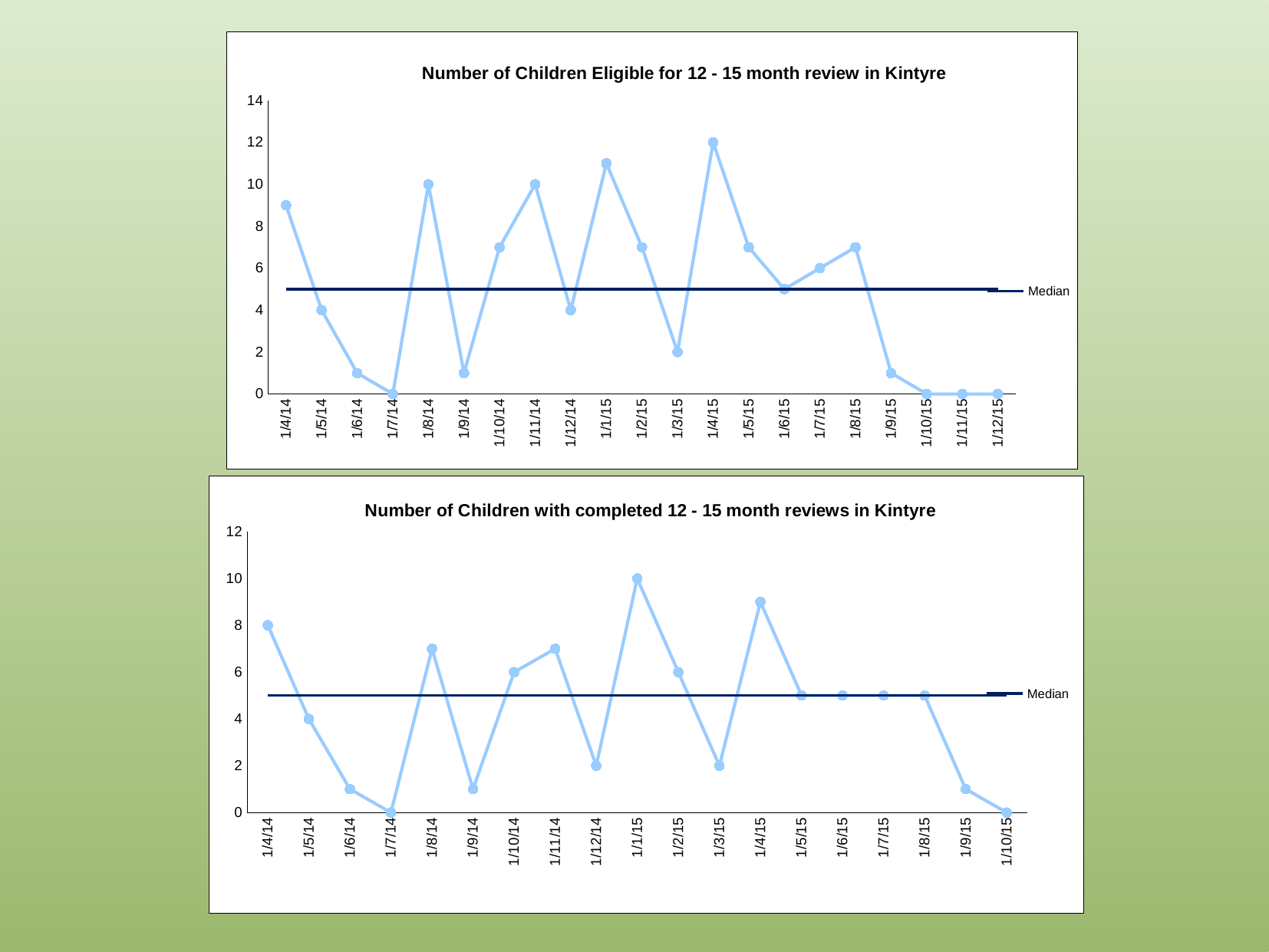
How many data points are plotted on the top chart (Number of Children Eligible for 12 - 15 month review in Kintyre)? 21 In the top chart (Number of Children Eligible for 12 - 15 month review in Kintyre), which date has the highest value? 1/4/15 What kind of chart is the top chart, 'Number of Children Eligible for 12 - 15 month review in Kintyre'? line chart In the top chart (Number of Children Eligible for 12 - 15 month review in Kintyre), what is the difference between the values for 1/4/15 and 1/8/14? 2 What is the label of the horizontal reference line shown in the legend of the bottom chart (Number of Children with completed 12 - 15 month reviews in Kintyre)? Median In the bottom chart (Number of Children with completed 12 - 15 month reviews in Kintyre), which is larger: the value for 1/10/14 or the value for 1/12/14? 1/10/14 In the top chart (Number of Children Eligible for 12 - 15 month review in Kintyre), what is the value for 1/8/14? 10 In the bottom chart (Number of Children with completed 12 - 15 month reviews in Kintyre), what is the value for 1/4/14? 8 In the top chart (Number of Children Eligible for 12 - 15 month review in Kintyre), is the value for 1/1/15 greater or less than 10? greater In the bottom chart (Number of Children with completed 12 - 15 month reviews in Kintyre), which date has the highest value? 1/1/15 In the bottom chart (Number of Children with completed 12 - 15 month reviews in Kintyre), do the values rise or fall from 1/8/15 to 1/10/15? fall In the top chart (Number of Children Eligible for 12 - 15 month review in Kintyre), what is the value for 1/4/15? 12